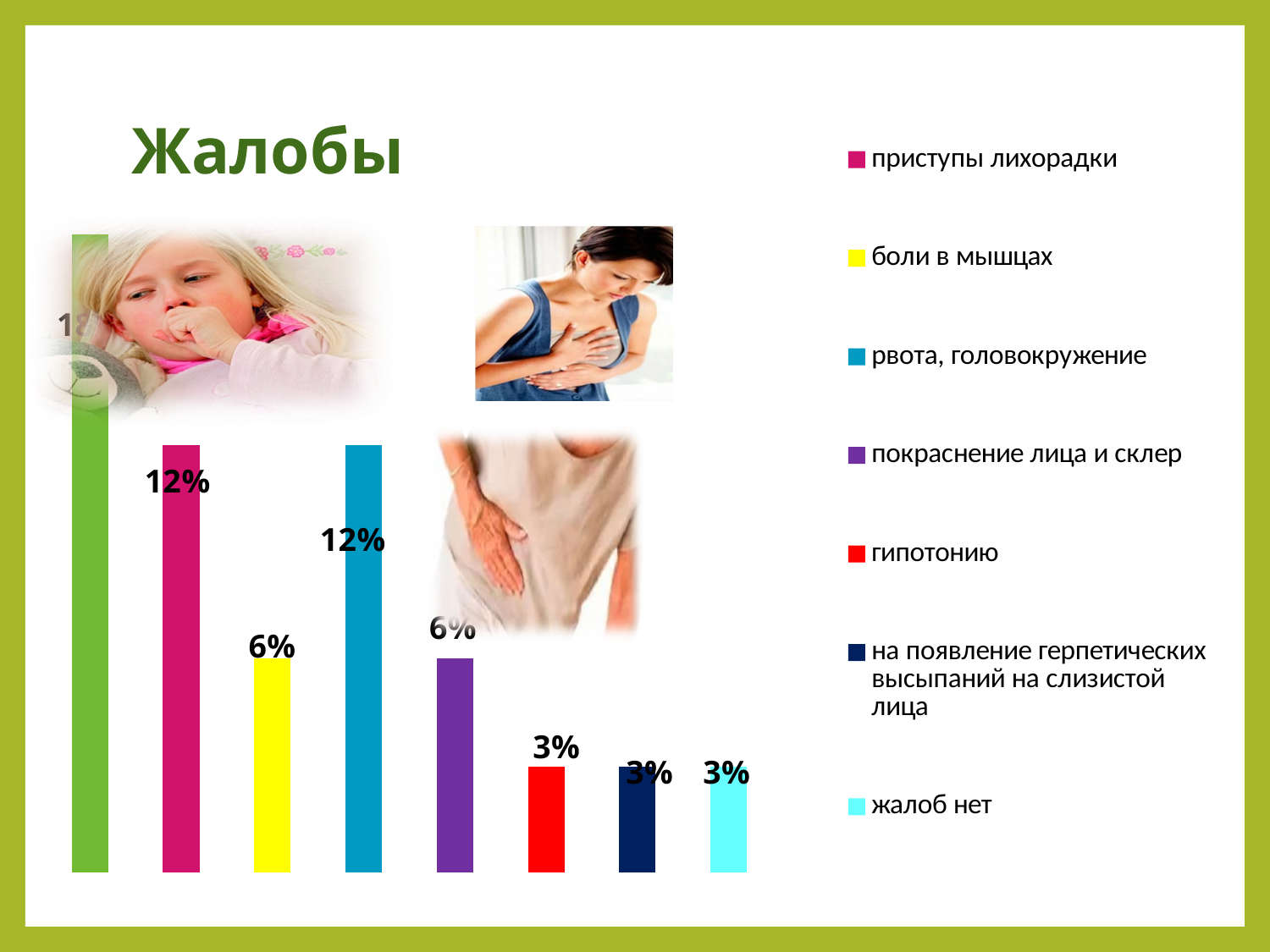
What is the value for жалоб нет? 3% What is the value for приступы лихорадки? 12% What is the difference between the values for рвота, головокружение and гипотонию? 9% What is the value for покраснение лица и склер? 6% What is the value for боли в мышцах? 6% What is the value for гипотонию? 3% What is the value for рвота, головокружение? 12% What kind of chart is shown on the slide? bar chart What is the difference between the values for приступы лихорадки and боли в мышцах? 6% What is the title of the slide? Жалобы Which is larger, the value for боли в мышцах or the value for гипотонию? боли в мышцах How many entries does the legend list? 7